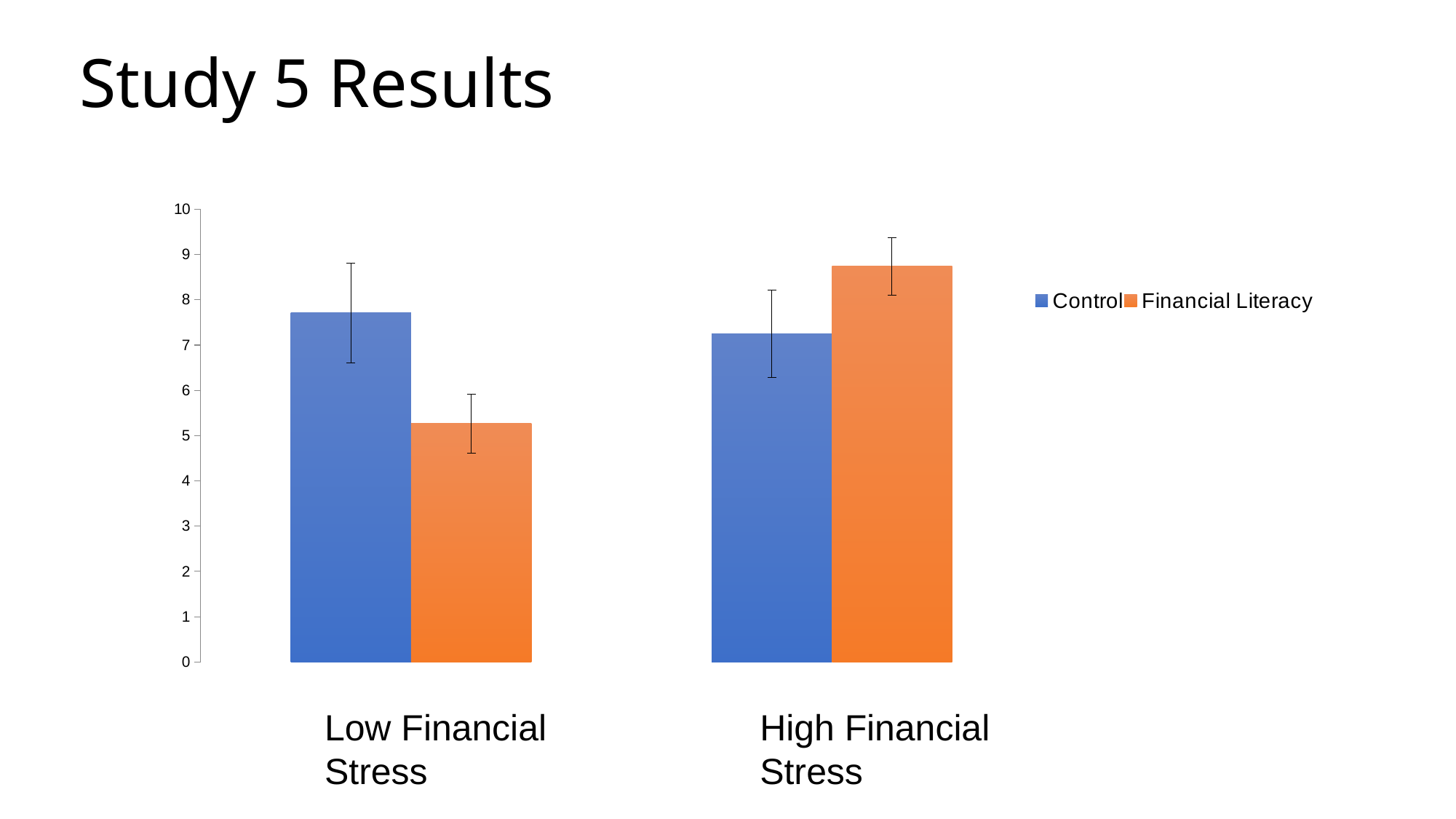
Which series is shown in orange? Financial Literacy Is the Control value for High Financial Stress greater or less than 8? less For Low Financial Stress, which is larger: Control or Financial Literacy? Control Is the Financial Literacy value for Low Financial Stress greater or less than 6? less Is the Control value for Low Financial Stress greater or less than 7? greater What is the title of the slide containing the chart? Study 5 Results How many series does the legend list? 2 Which bar is the tallest in the chart? Financial Literacy at High Financial Stress What kind of chart is shown on the slide? bar chart For High Financial Stress, which is larger: Control or Financial Literacy? Financial Literacy How many categories are shown on the x axis? 2